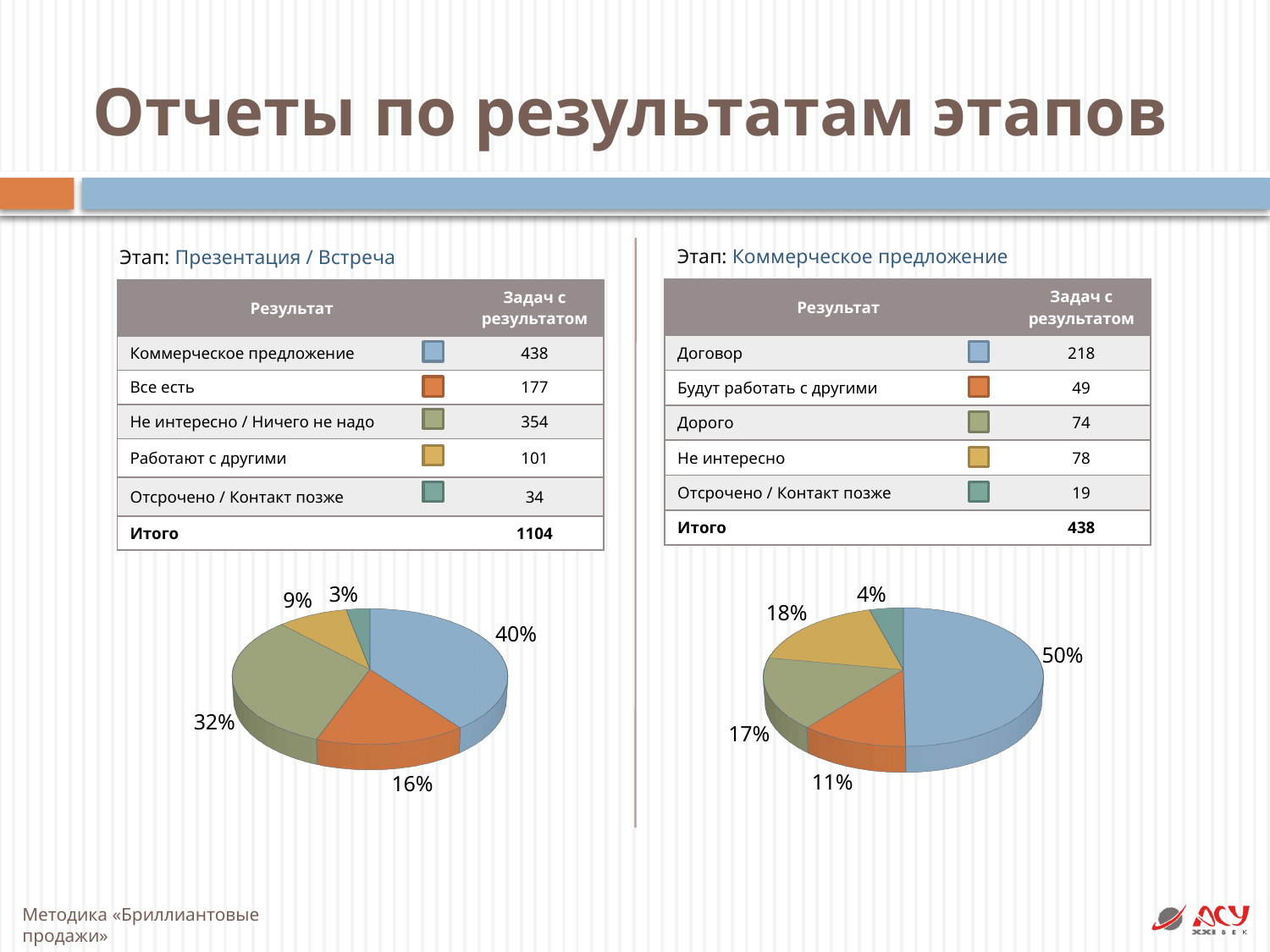
In the right table (stage "Коммерческое предложение"), how many tasks have the result "Дорого"? 74 In the right table (stage "Коммерческое предложение"), which has more tasks: "Будут работать с другими" or "Отсрочено / Контакт позже"? Будут работать с другими What kind of chart is shown under the stage "Презентация / Встреча" on the left of the slide? Pie chart In the left table (stage "Презентация / Встреча"), what is the total ("Итого") number of tasks? 1104 In the right table (stage "Коммерческое предложение"), which result has the highest number of tasks? Договор In the right pie chart (stage "Коммерческое предложение"), what share is shown for the largest slice? 50% In the right table (stage "Коммерческое предложение"), what is the difference between the number of tasks for "Не интересно" and for "Дорого"? 4 In the left table (stage "Презентация / Встреча"), how many tasks have the result "Не интересно / Ничего не надо"? 354 In the left pie chart (stage "Презентация / Встреча"), what share is shown for the smallest slice? 3% In the left pie chart (stage "Презентация / Встреча"), what share is shown for the largest slice? 40% In the left pie chart (stage "Презентация / Встреча"), how many slices does the pie have? 5 In the left table (stage "Презентация / Встреча"), which result has the lowest number of tasks? Отсрочено / Контакт позже